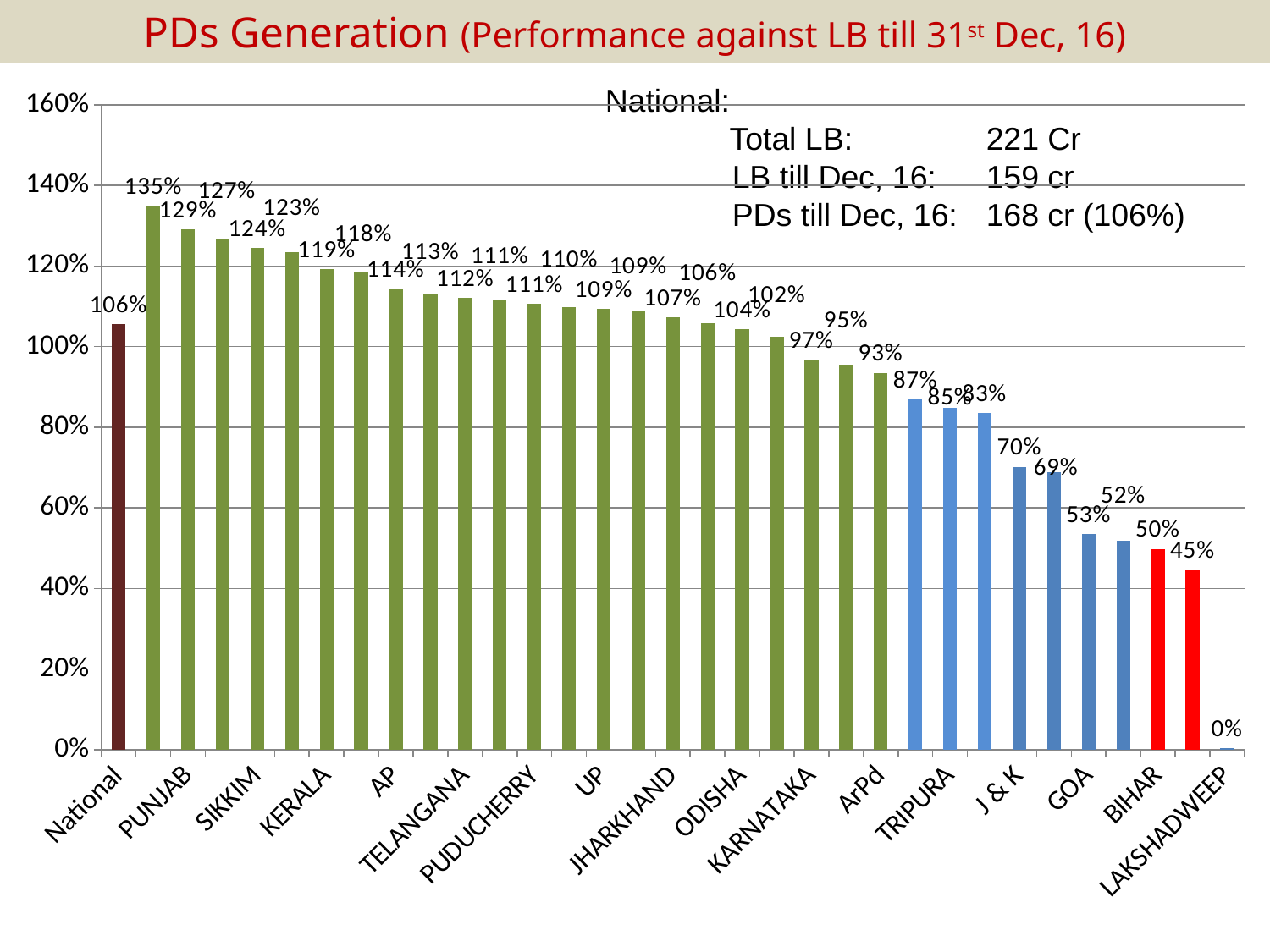
Is the value for TRIPURA greater or less than 100%? less Which has a larger value, PUNJAB or GOA? PUNJAB What is the value shown for LAKSHADWEEP? 0% How many bars are plotted in the chart? 33 What is the value shown for National? 106% Which category has the lowest value? LAKSHADWEEP Is the value for PUNJAB greater or less than 120%? greater What is the highest value labelled on any bar in the chart? 135% Is the value for BIHAR greater or less than 60%? less Do the state values generally rise or fall moving from left to right across the chart? Fall What kind of chart is shown on the slide? Bar chart According to the text box on the chart, what is the national Total LB? 221 Cr